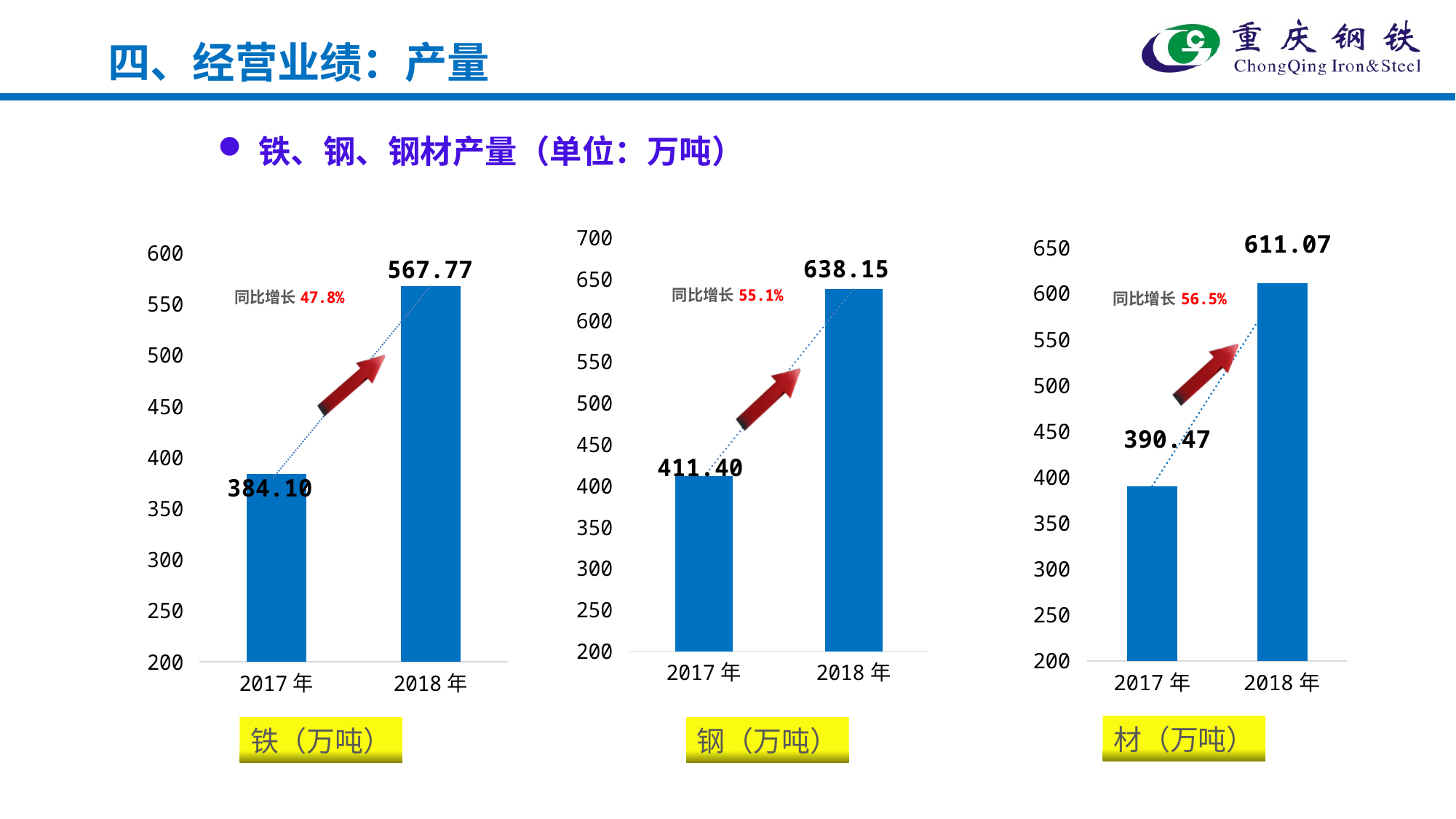
In the middle chart (钢), do the values rise or fall from 2017年 to 2018年? rise In the middle chart (钢), what is the value for 2017年? 411.40 What kind of chart is the left chart (铁)? bar chart In the middle chart (钢), what is the value for 2018年? 638.15 In the right chart (材), what is the value for 2017年? 390.47 In the right chart (材), which year has the higher value? 2018年 In the left chart (铁), what is the value for 2017年? 384.10 How many charts are shown on the slide? 3 In the left chart (铁), what is the difference between the 2018年 and 2017年 values? 183.67 In the right chart (材), what is the value for 2018年? 611.07 In the left chart (铁), what is the value for 2018年? 567.77 In the middle chart (钢), what is the difference between the 2018年 and 2017年 values? 226.75